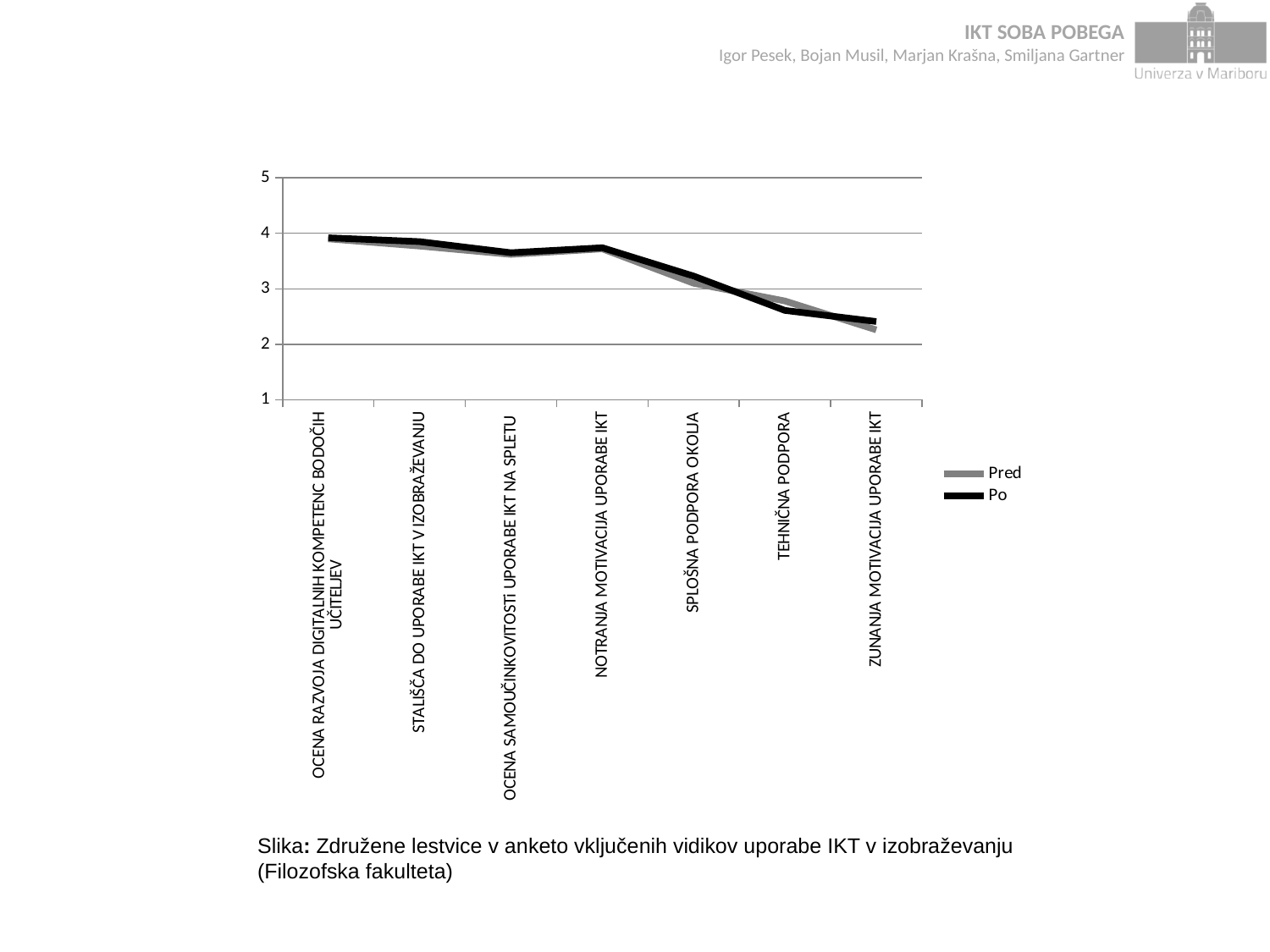
What kind of chart is shown on the slide? line chart Is the Po value for TEHNIČNA PODPORA greater or less than 3? less Which series is drawn with the black line? Po How many series does the legend list? 2 Do the values generally rise or fall from left to right along the x axis? fall Is the Po value for OCENA RAZVOJA DIGITALNIH KOMPETENC BODOČIH UČITELJEV greater or less than 3? greater Is the Po value for NOTRANJA MOTIVACIJA UPORABE IKT greater or less than 3? greater Which is larger for the Po series: NOTRANJA MOTIVACIJA UPORABE IKT or TEHNIČNA PODPORA? NOTRANJA MOTIVACIJA UPORABE IKT Which category has the lowest values for both series? ZUNANJA MOTIVACIJA UPORABE IKT How many categories are plotted along the x axis? 7 For TEHNIČNA PODPORA, which series has the higher value, Pred or Po? Pred